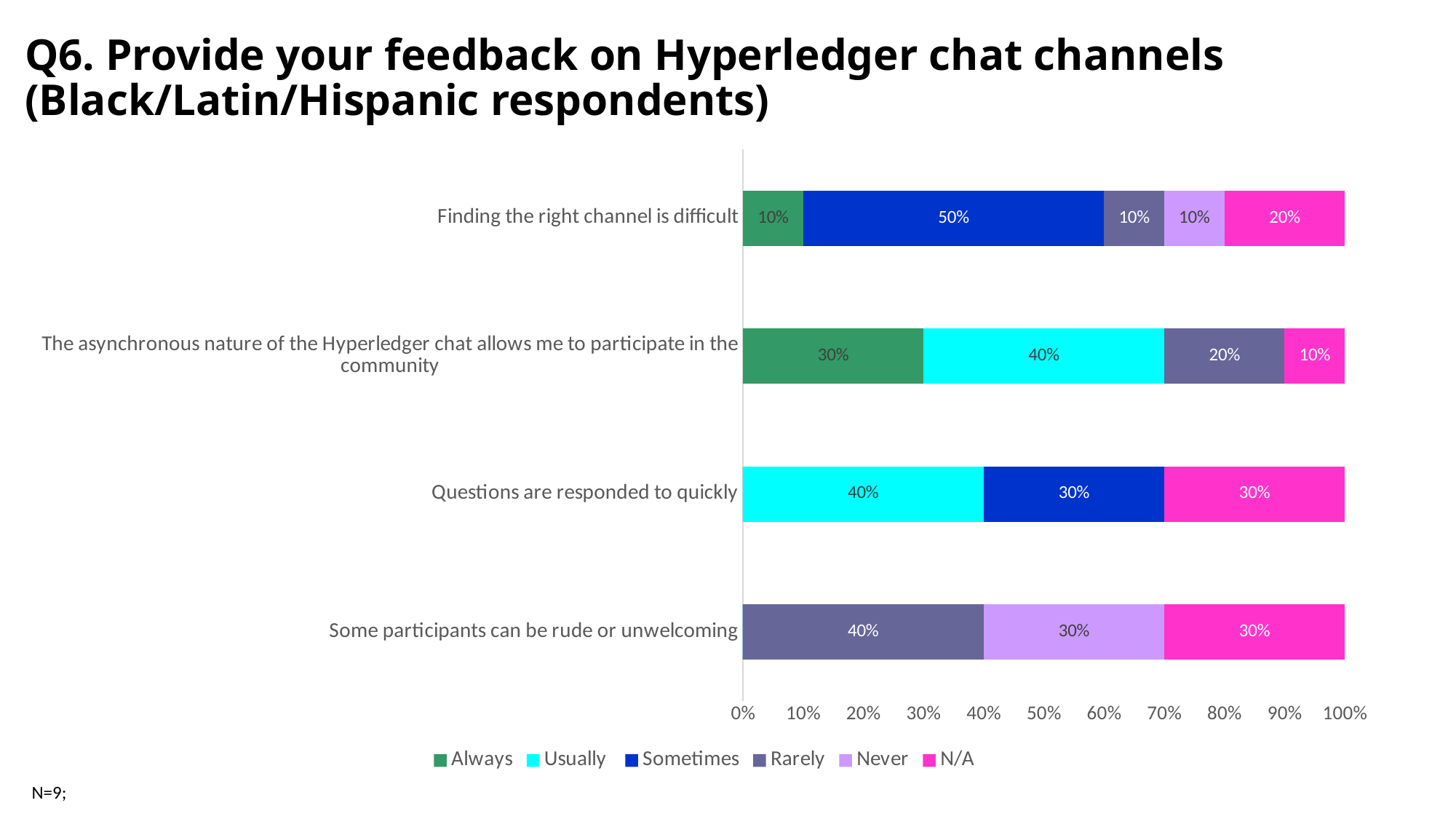
For 'The asynchronous nature of the Hyperledger chat allows me to participate in the community', which is larger: the 'Usually' share or the 'Rarely' share? Usually What percentage of respondents answered 'Never' for 'Finding the right channel is difficult'? 10% What percentage of respondents answered 'Always' for 'The asynchronous nature of the Hyperledger chat allows me to participate in the community'? 30% What percentage of respondents answered 'N/A' for 'Questions are responded to quickly'? 30% What is the sample size (N) noted on the slide? N=9 What is the difference between the 'Usually' and 'Sometimes' shares for 'Questions are responded to quickly'? 10% What type of chart is shown on the slide? Stacked bar chart Which response category has the largest share for 'Finding the right channel is difficult'? Sometimes How many response options does the legend list? 6 What percentage of respondents answered 'Sometimes' for 'Finding the right channel is difficult'? 50% What percentage of respondents answered 'Rarely' for 'Some participants can be rude or unwelcoming'? 40% How many statements (categories) are shown on the chart? 4